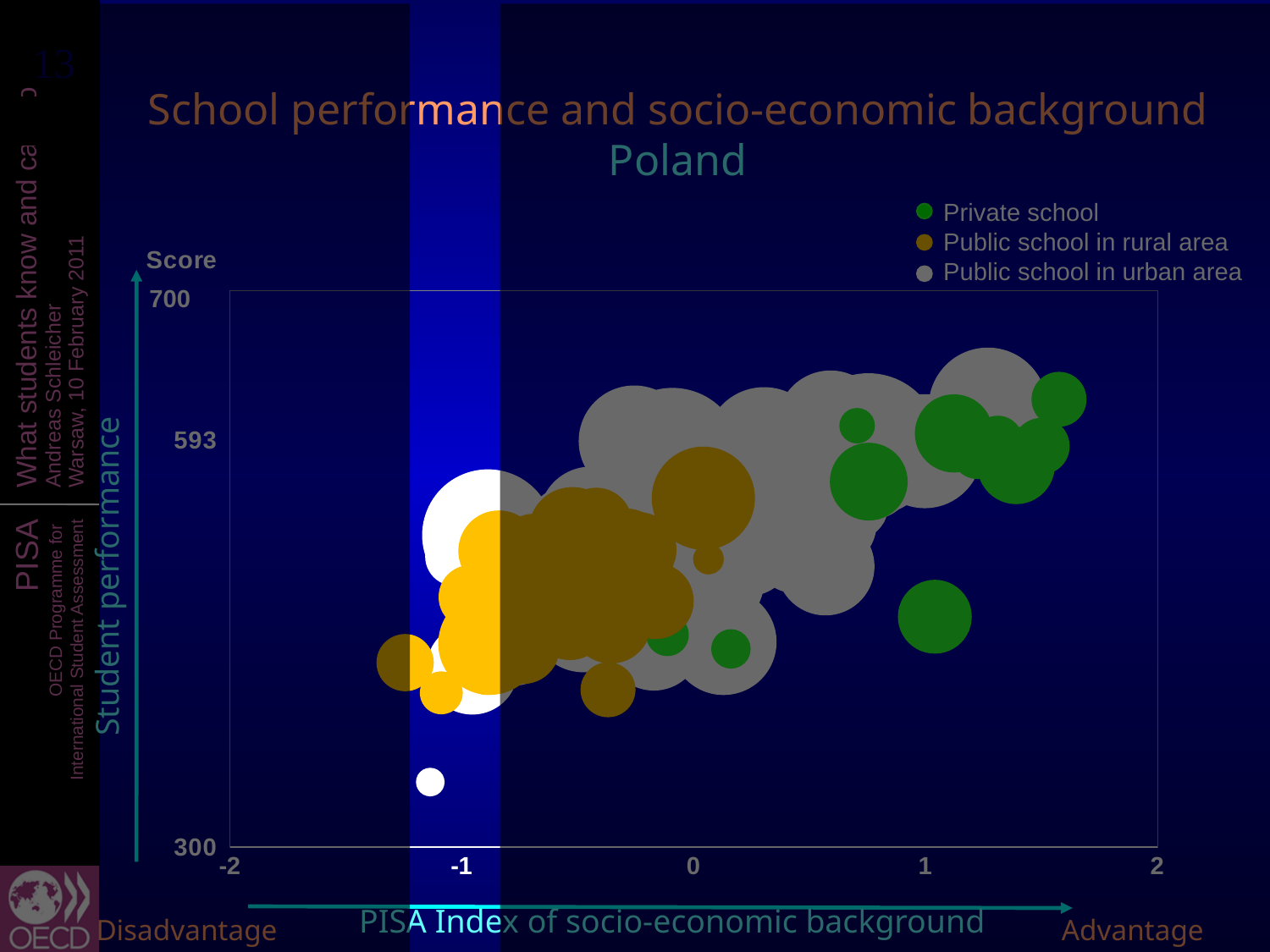
What is the label of the horizontal axis? PISA Index of socio-economic background What is the highest value shown on the vertical Score axis? 700 What is the lowest value shown on the vertical Score axis? 300 What kind of chart is shown on the slide? Bubble chart (scatter plot) Which series has its bubbles concentrated furthest to the left (lowest socio-economic index)? Public school in rural area How many series does the legend list? 3 What is the intermediate score value marked on the vertical axis between 300 and 700? 593 Do student performance scores generally rise or fall as the PISA index of socio-economic background increases? Rise What is the title of the chart? School performance and socio-economic background Poland Which series has its bubbles located furthest to the right (highest socio-economic index)? Private school What is the range of the horizontal axis? -2 to 2 Which series is shown in green in the legend? Private school